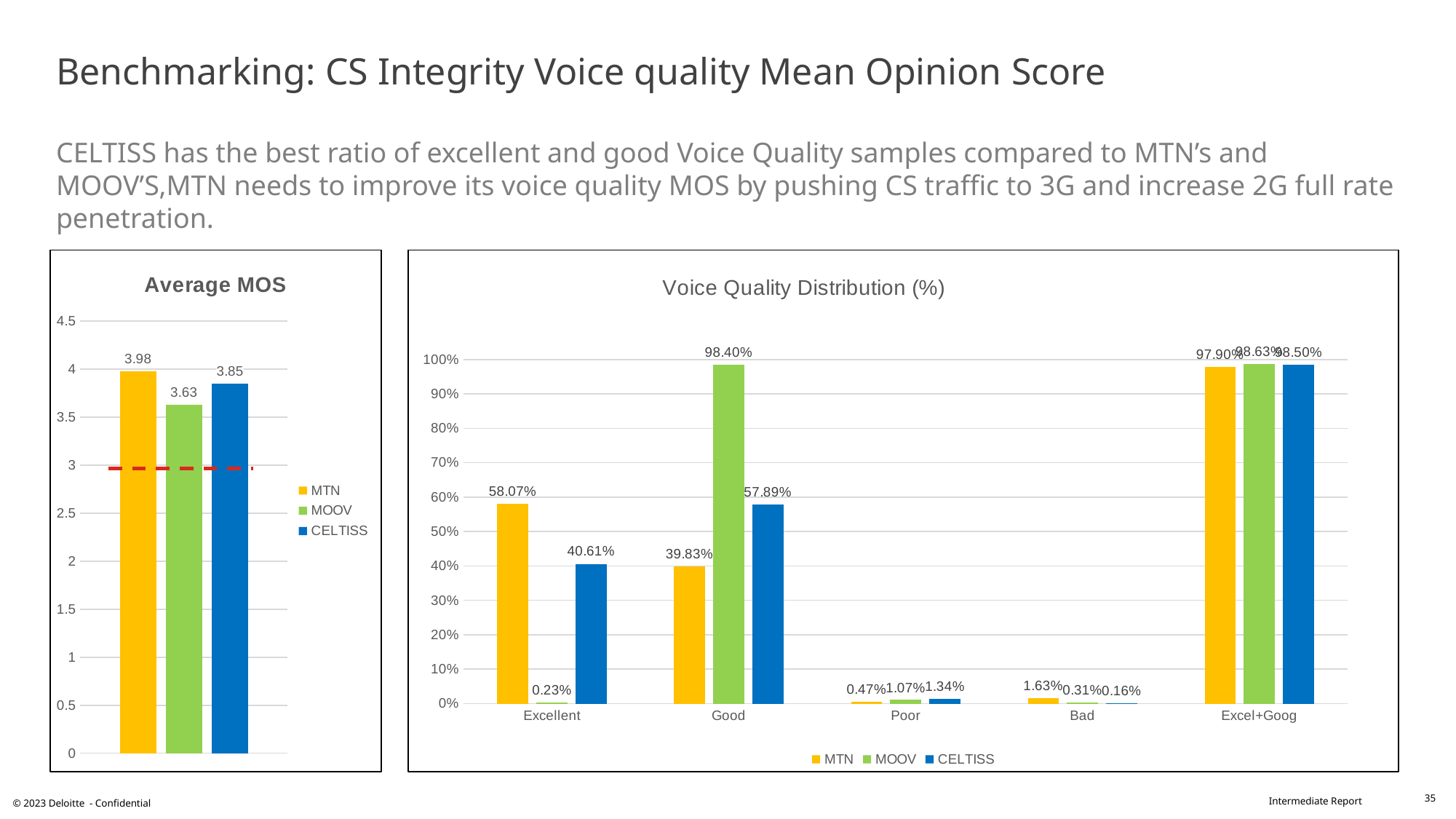
What type of chart is the Voice Quality Distribution (%) chart? Bar chart In the Voice Quality Distribution (%) chart, what is the value for MOOV in the Good category? 98.40% In the Average MOS chart, how many series does the legend list? 3 In the Voice Quality Distribution (%) chart, which operator has the highest value in the Excellent category? MTN In the Voice Quality Distribution (%) chart, is MTN's value in the Good category larger or smaller than CELTISS's value in the Good category? smaller In the Average MOS chart, what is the value for MTN? 3.98 In the Voice Quality Distribution (%) chart, what is the difference between MTN's and MOOV's values in the Excel+Goog category? 0.73% In the Average MOS chart, what is the difference between MTN's and CELTISS's values? 0.13 In the Voice Quality Distribution (%) chart, which operator has the lowest value in the Bad category? CELTISS In the Average MOS chart, which operator has the lowest average MOS? MOOV In the Voice Quality Distribution (%) chart, what is the value for CELTISS in the Excellent category? 40.61% How many categories are shown on the x axis of the Voice Quality Distribution (%) chart? 5